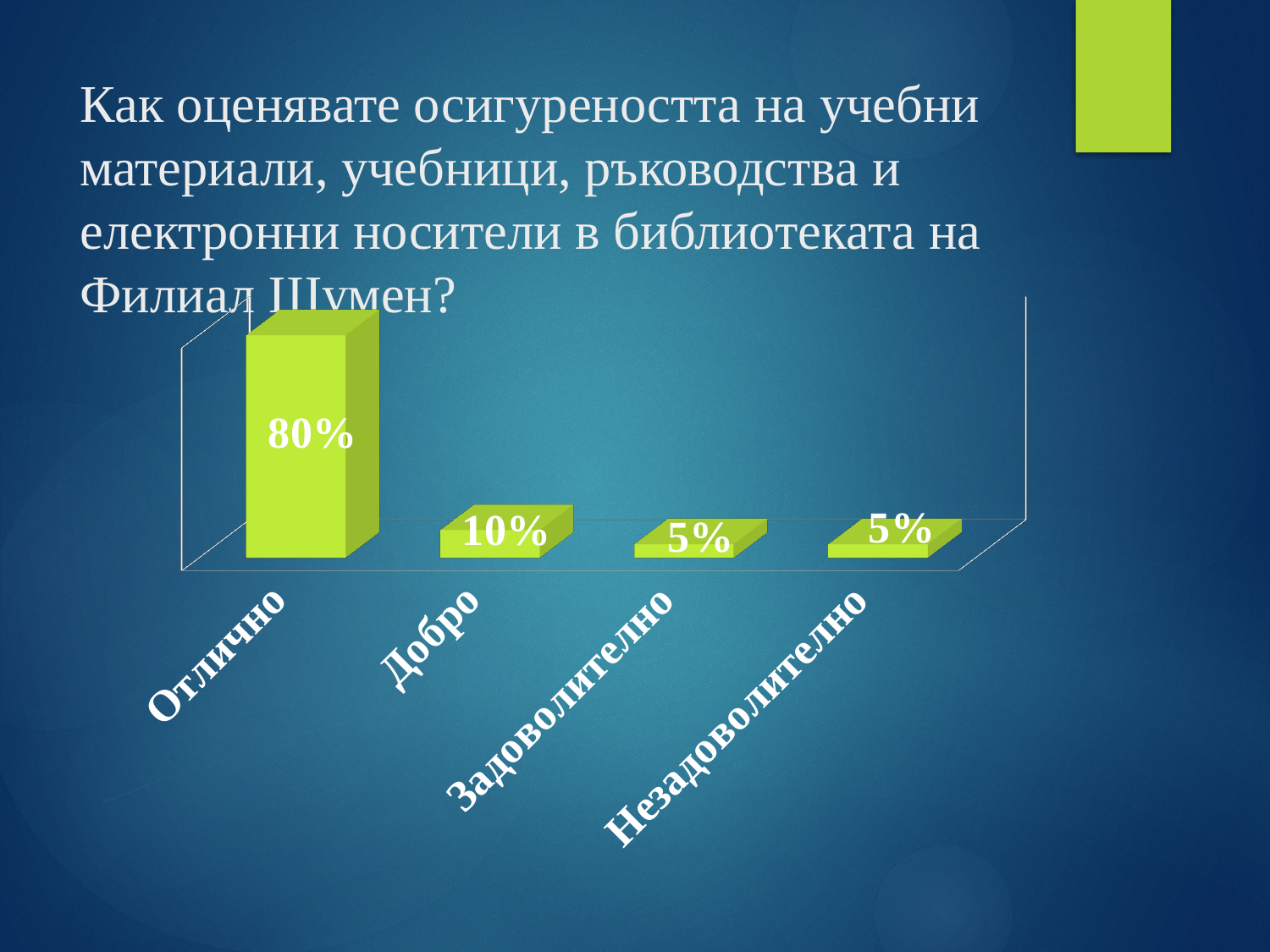
What is the value for Добро? 10% What is the value for Отлично? 80% Which category has the highest value? Отлично What is the value for Задоволително? 5% What kind of chart is shown on the slide? bar chart What is the difference between the values for Отлично and Добро? 70% What colour are the bars in the chart? green What is the difference between the values for Добро and Задоволително? 5% Do the values rise or fall from left to right along the x axis? fall Which is larger, the value for Отлично or the value for Добро? Отлично How many categories are shown on the chart? 4 What is the value for Незадоволително? 5%